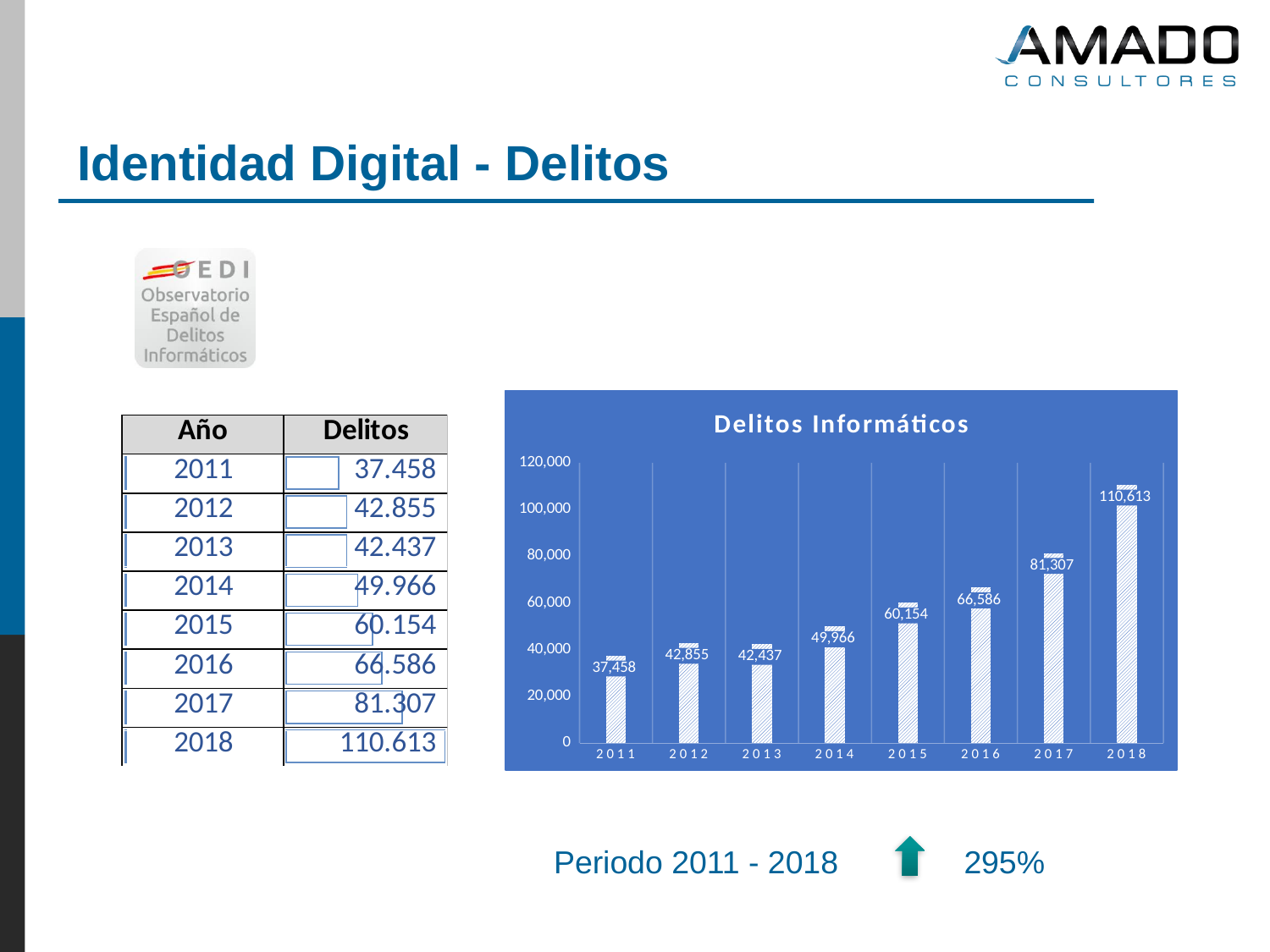
Which year has the highest value in the Delitos Informáticos chart? 2018 Which year has the lowest value in the Delitos Informáticos chart? 2011 Which is larger in the Delitos Informáticos chart, the value for 2016 or the value for 2017? 2017 Do the values in the Delitos Informáticos chart generally rise or fall from 2011 to 2018? rise What is the value for 2018 in the Delitos Informáticos chart? 110,613 What is the value for 2011 in the Delitos Informáticos chart? 37,458 What is the value for 2015 in the Delitos Informáticos chart? 60,154 How many years are shown on the x axis of the Delitos Informáticos chart? 8 What is the difference between the values for 2018 and 2017 in the Delitos Informáticos chart? 29,306 Is the value for 2017 in the Delitos Informáticos chart greater or less than 80,000? greater What kind of chart is the Delitos Informáticos chart? bar chart What is the difference between the values for 2012 and 2011 in the Delitos Informáticos chart? 5,397